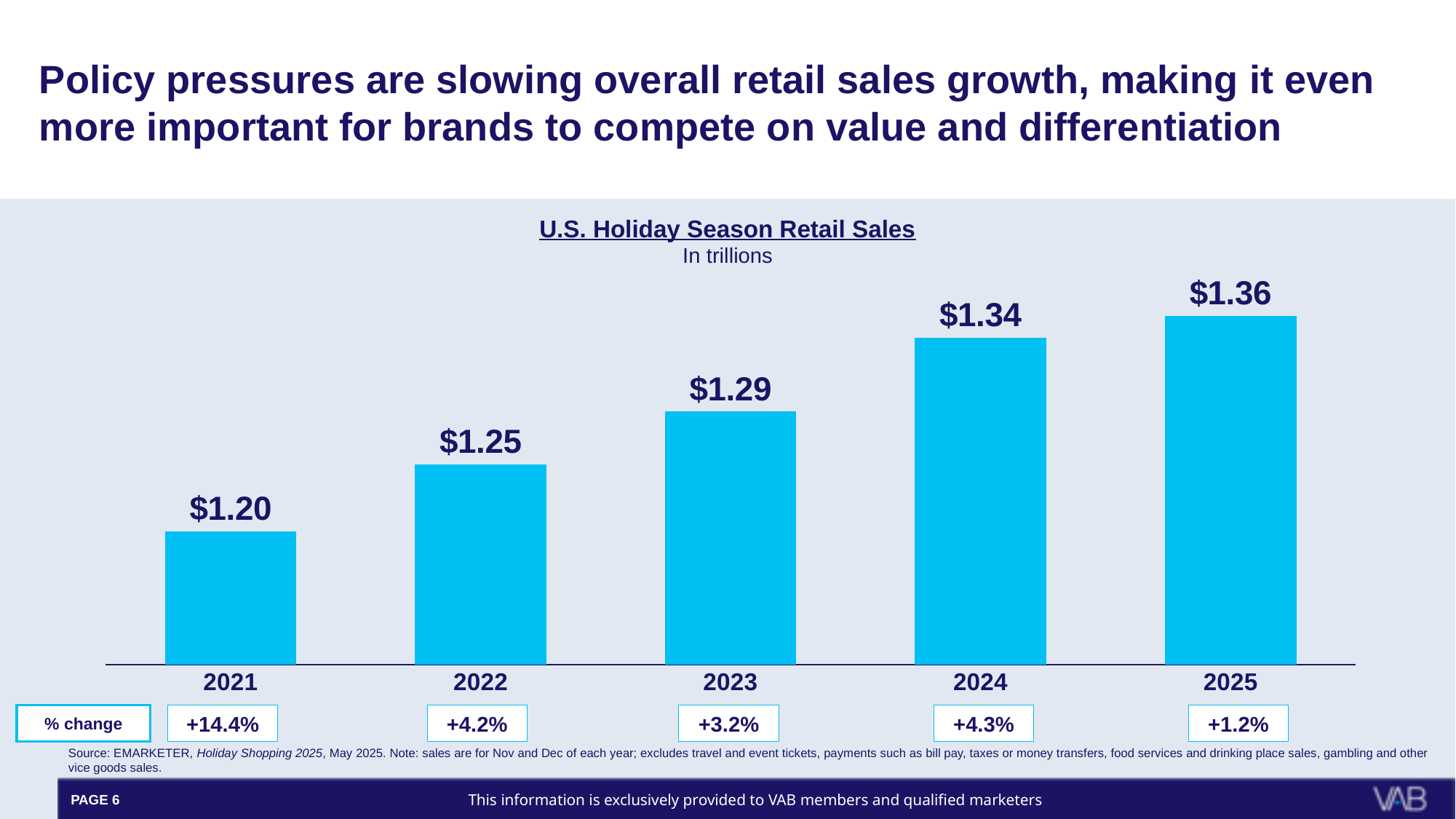
How many years are shown in the chart? 5 Which year has the lowest holiday season retail sales? 2021 What kind of chart is shown on the slide? Bar chart In what units are the chart values expressed? In trillions What is the difference in holiday season retail sales between 2025 and 2021? $0.16 Which year has higher holiday season retail sales, 2022 or 2024? 2024 What is the U.S. holiday season retail sales value for 2023? $1.29 Which year has the highest holiday season retail sales? 2025 What is the percent change shown for 2025? +1.2% What is the percent change shown for 2021? +14.4% Do holiday season retail sales rise or fall from 2021 to 2025? Rise What is the U.S. holiday season retail sales value for 2021? $1.20